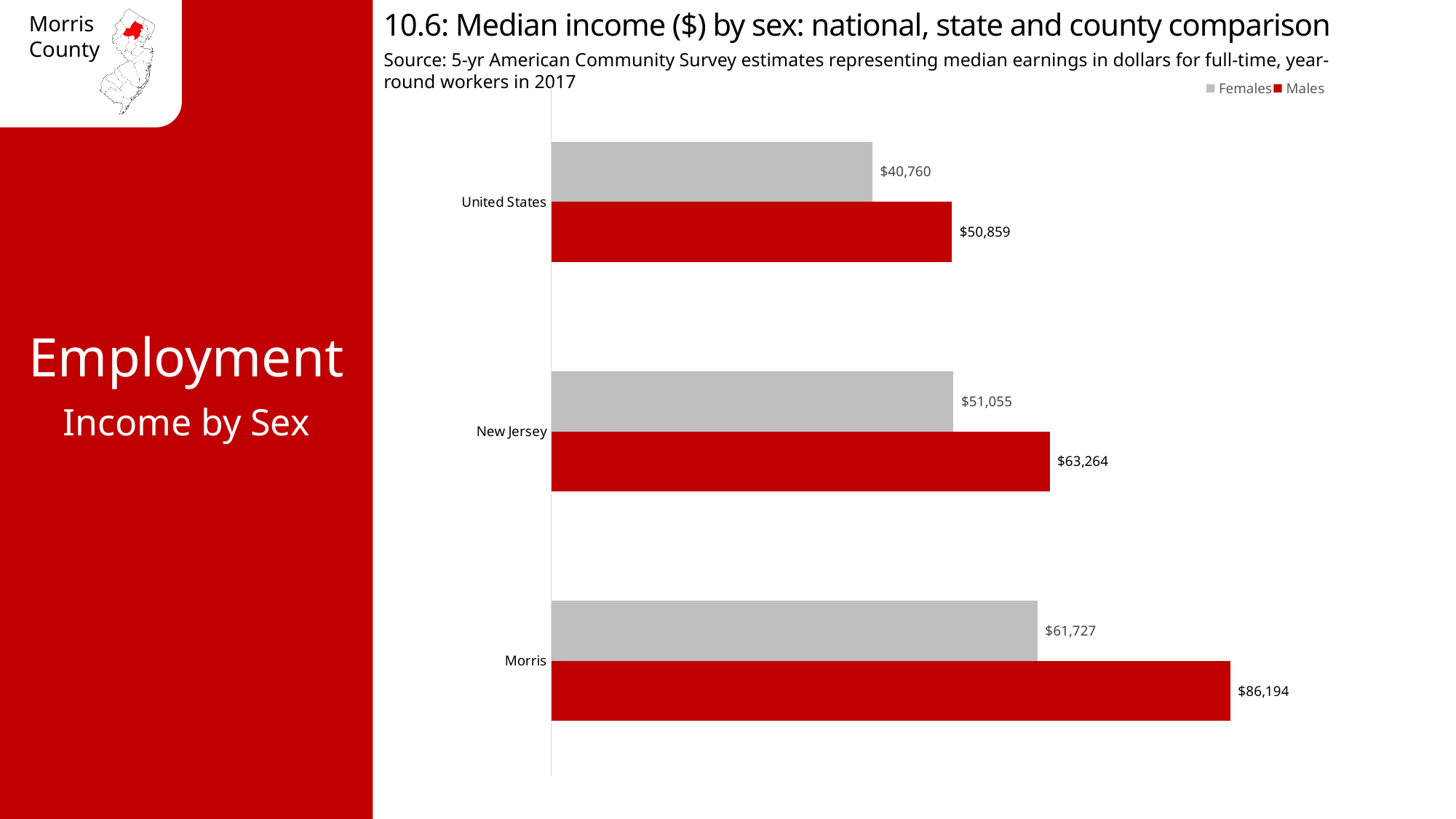
What is the median income for females in Morris? $61,727 What is the difference between male and female median income in Morris? $24,467 Which category has the highest median income for males? Morris How many categories are shown on the chart? 3 What is the median income for males in New Jersey? $63,264 What is the median income for females in the United States? $40,760 What kind of chart is shown on the slide? Bar chart What is the difference between male and female median income in the United States? $10,099 Which category has the lowest median income for females? United States How many series does the legend list? 2 What is the median income for males in Morris? $86,194 Which is larger: the female median income in New Jersey or the male median income in the United States? Female median income in New Jersey